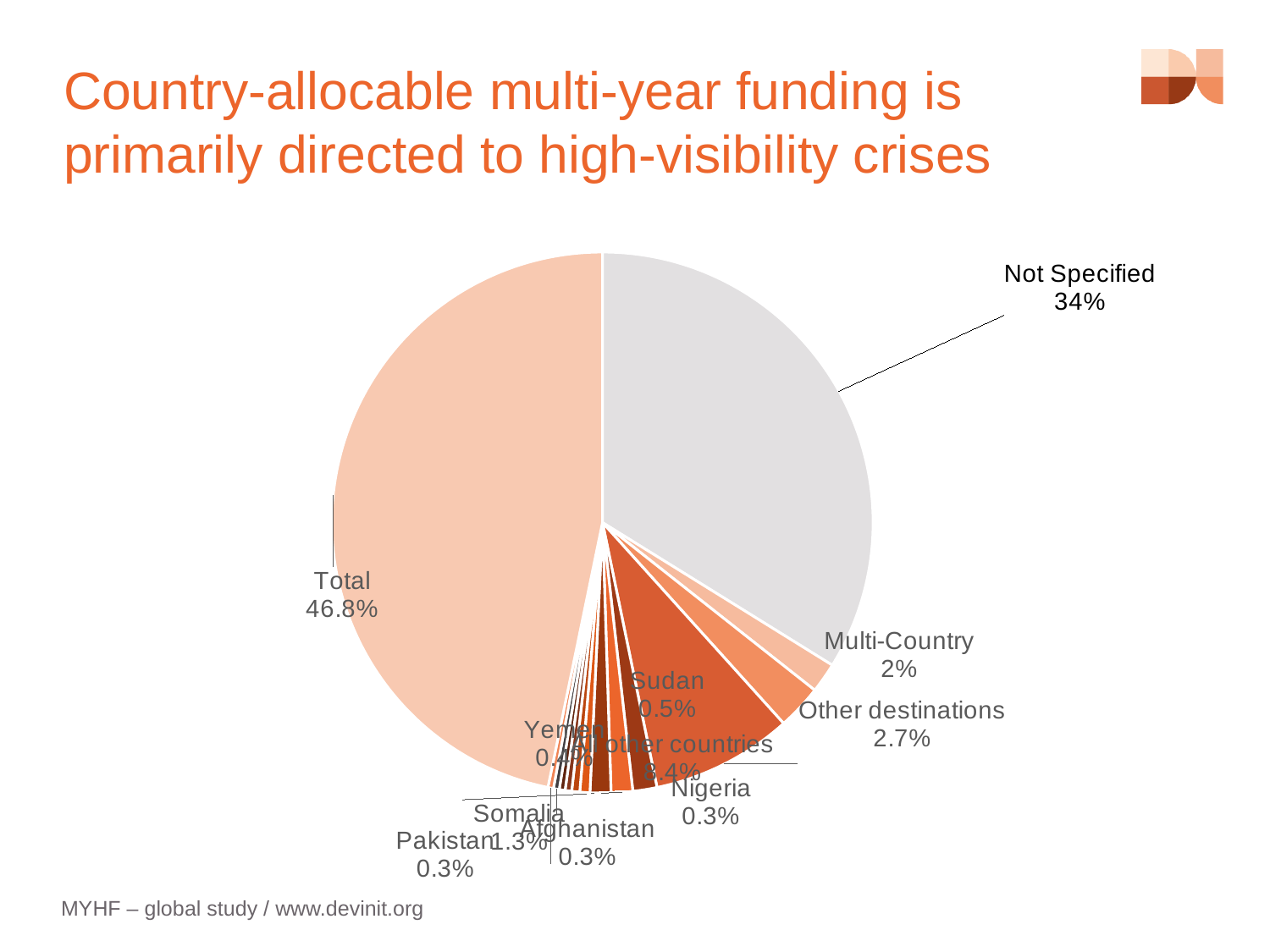
What is the value shown for Multi-Country? 2% What is the difference in percentage points between the Total slice (46.8%) and the Not Specified slice (34%)? 12.8 percentage points What is the value shown for Somalia? 1.3% What is the title of the slide containing the pie chart? Country-allocable multi-year funding is primarily directed to high-visibility crises Which labelled slice has the largest share of the pie? Total Which is larger, the Not Specified slice or the Multi-Country slice? Not Specified What kind of chart is shown on the slide? pie chart What is the value shown for Sudan? 0.5% What is the value shown for the Total slice? 46.8% What is the value shown for Other destinations? 2.7% What is the value shown for Nigeria? 0.3% What share of the pie is labelled Not Specified? 34%